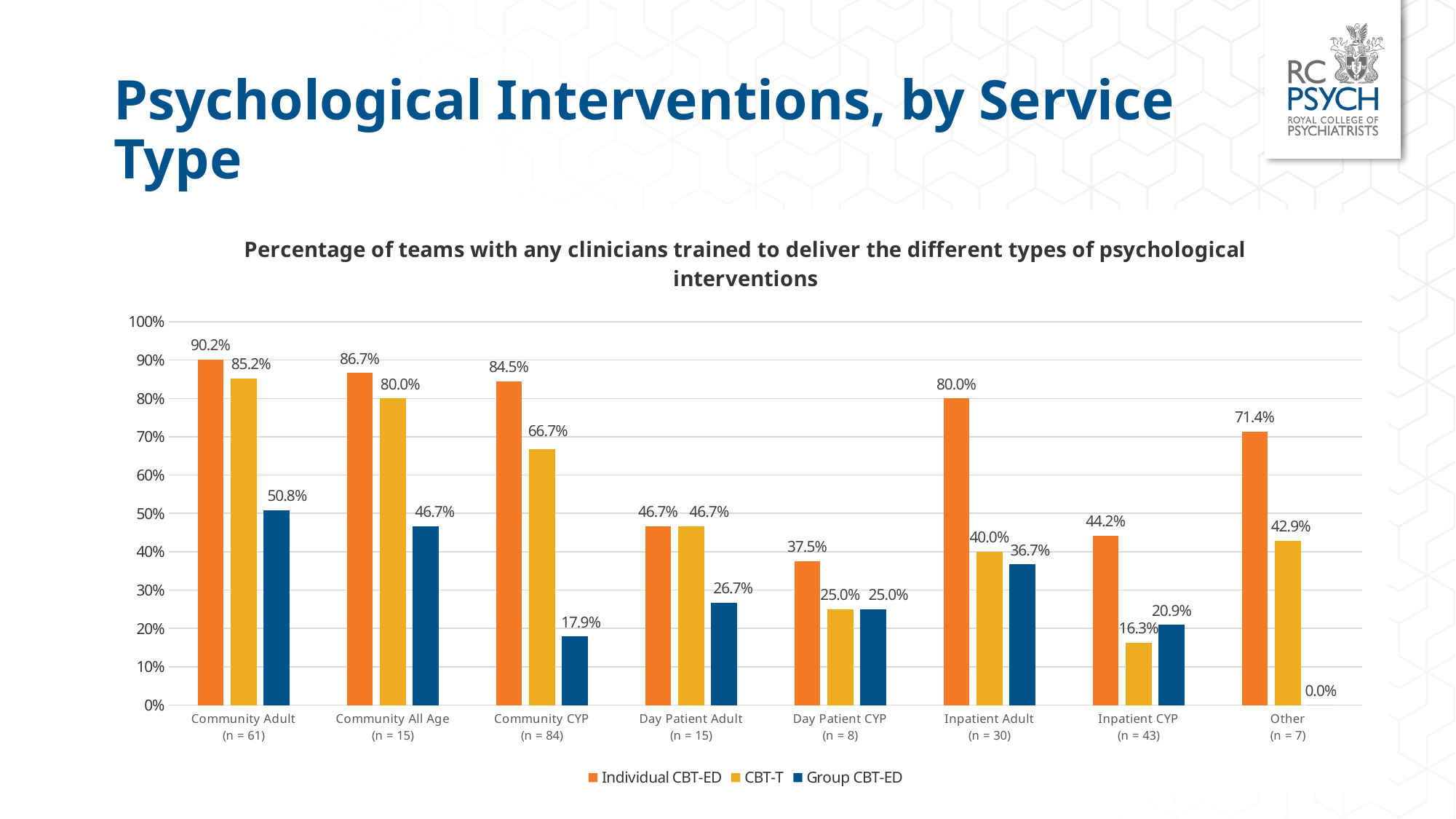
How many service type categories are shown on the x axis? 8 Which service type has the lowest Group CBT-ED value? Other How many series does the legend list? 3 What is the Group CBT-ED value for Community CYP? 17.9% Which service type has the highest Individual CBT-ED value? Community Adult Which is larger for Day Patient CYP: the Individual CBT-ED value or the CBT-T value? Individual CBT-ED What is the difference between the Individual CBT-ED and Group CBT-ED values for Inpatient Adult? 43.3% What kind of chart is shown on the slide? Bar chart What is the CBT-T value for Inpatient CYP? 16.3% Is the CBT-T value for Community CYP greater or less than 60%? greater What is the Individual CBT-ED value for Community Adult? 90.2% What is the sample size (n) shown for Community CYP? 84